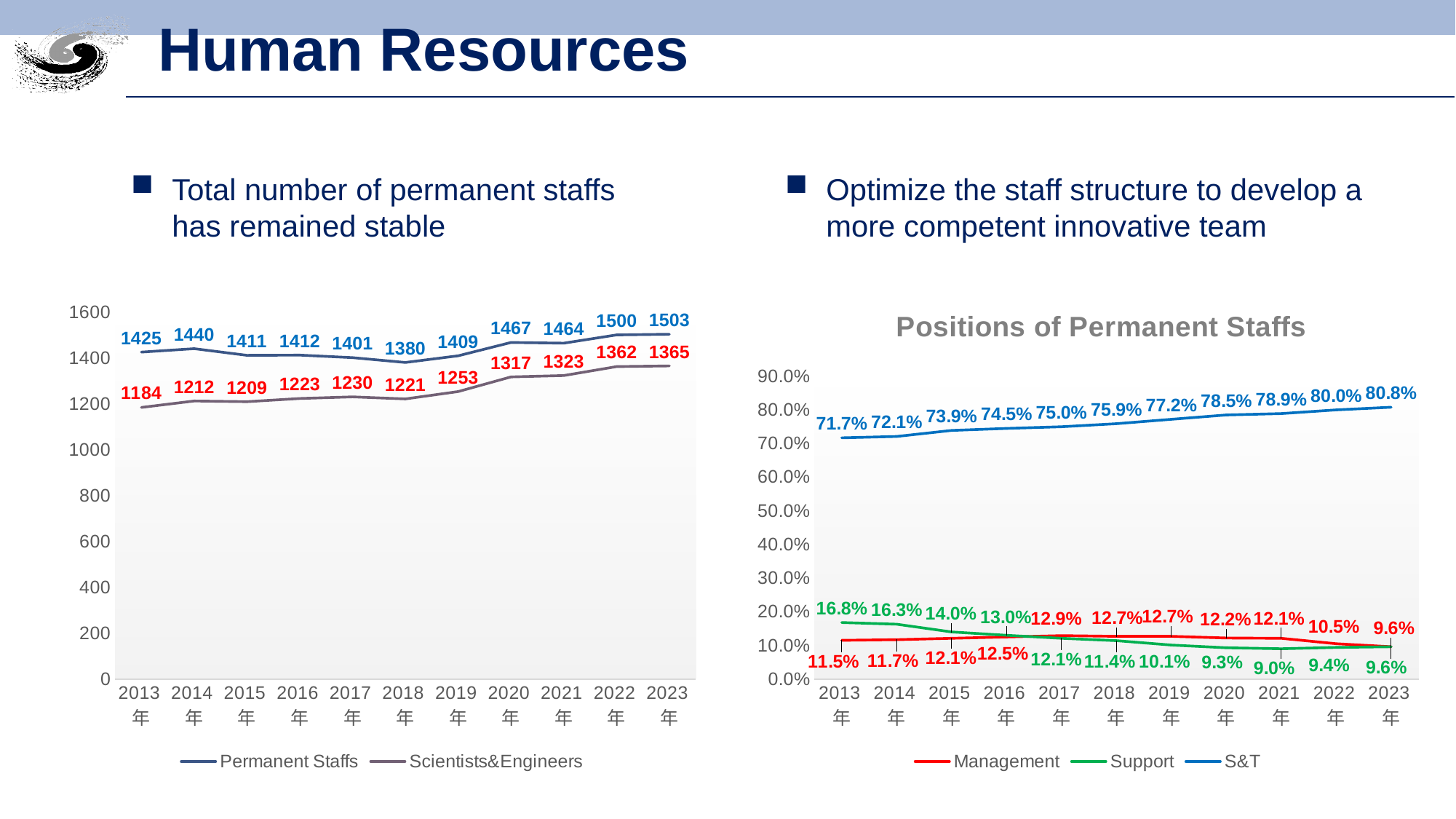
In the left chart, what is the difference between Permanent Staffs and Scientists&Engineers in 2023? 138 In the left chart, how many series does the legend list? 2 In the left chart, in which year is the Permanent Staffs value lowest? 2018 In the 'Positions of Permanent Staffs' chart, which is larger in 2016, Management or Support? Support In the 'Positions of Permanent Staffs' chart, does the S&T share rise or fall from 2013 to 2023? rise In the left chart, what is the value for Scientists&Engineers in 2020? 1317 In the 'Positions of Permanent Staffs' chart, which series has the highest value in 2013? S&T What kind of chart is the 'Positions of Permanent Staffs' chart? line chart In the 'Positions of Permanent Staffs' chart, what is the S&T share in 2019? 77.2% In the 'Positions of Permanent Staffs' chart, what is the Support share in 2021? 9.0% In the left chart, how many years are shown on the x axis? 11 In the left chart, what is the value for Permanent Staffs in 2018? 1380